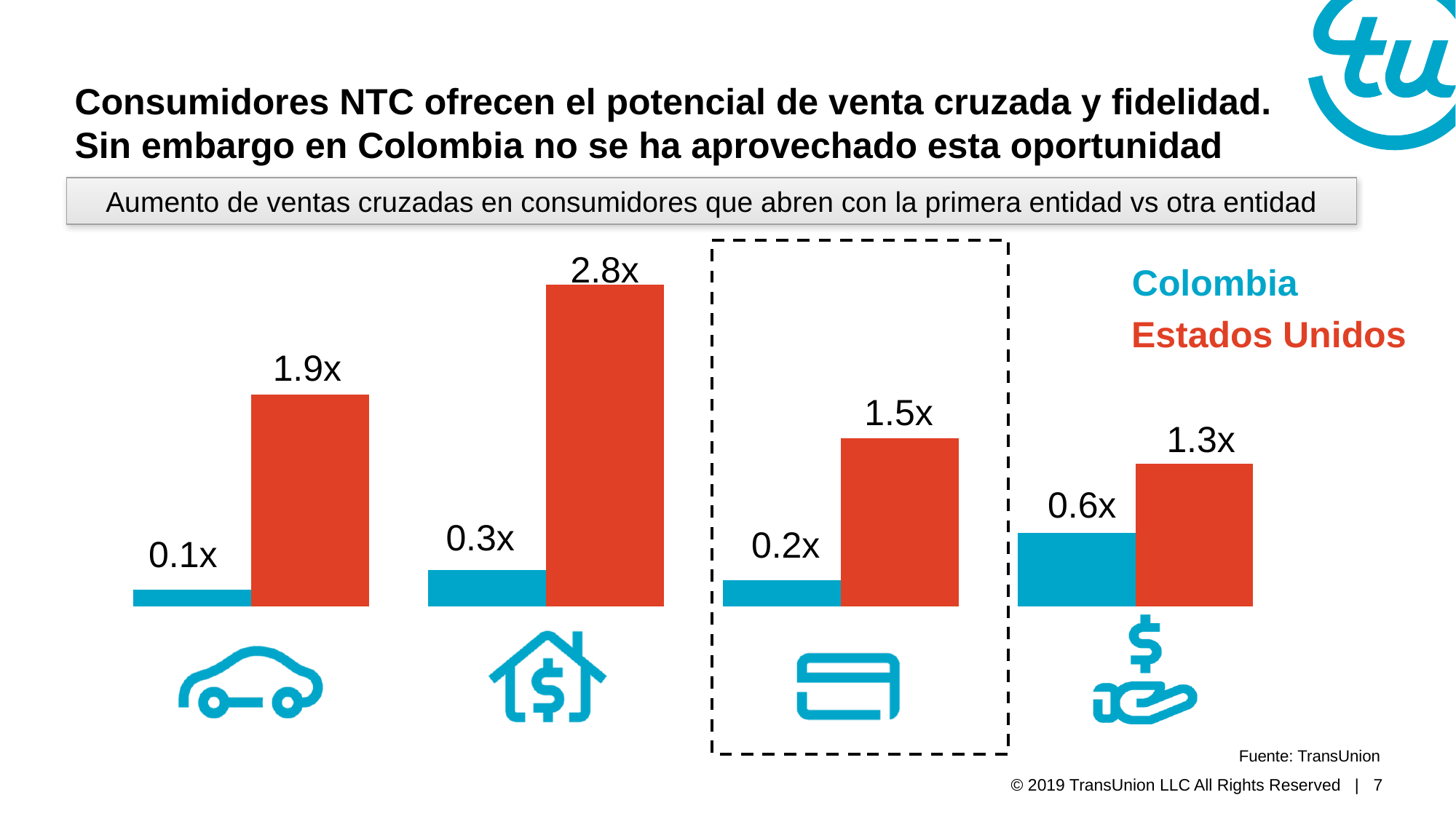
How many categories are shown in the chart? 4 In which category does Colombia have its lowest value? The car icon category (0.1x) What is the value for Estados Unidos in the category with the credit card icon (inside the dashed box)? 1.5x What type of chart is shown on the slide? Bar chart What is the difference between the Estados Unidos and Colombia values in the category with the house icon? 2.5x In the category with the credit card icon, which is larger: the Colombia value or the Estados Unidos value? Estados Unidos How many series does the legend list? 2 In which category does Estados Unidos have its highest value? The house icon category (2.8x) What is the value for Estados Unidos in the category with the car icon? 1.9x What is the value for Colombia in the rightmost category (hand with dollar icon)? 0.6x What is the value for Colombia in the category with the house icon? 0.3x Which colour represents Colombia in the chart? Blue